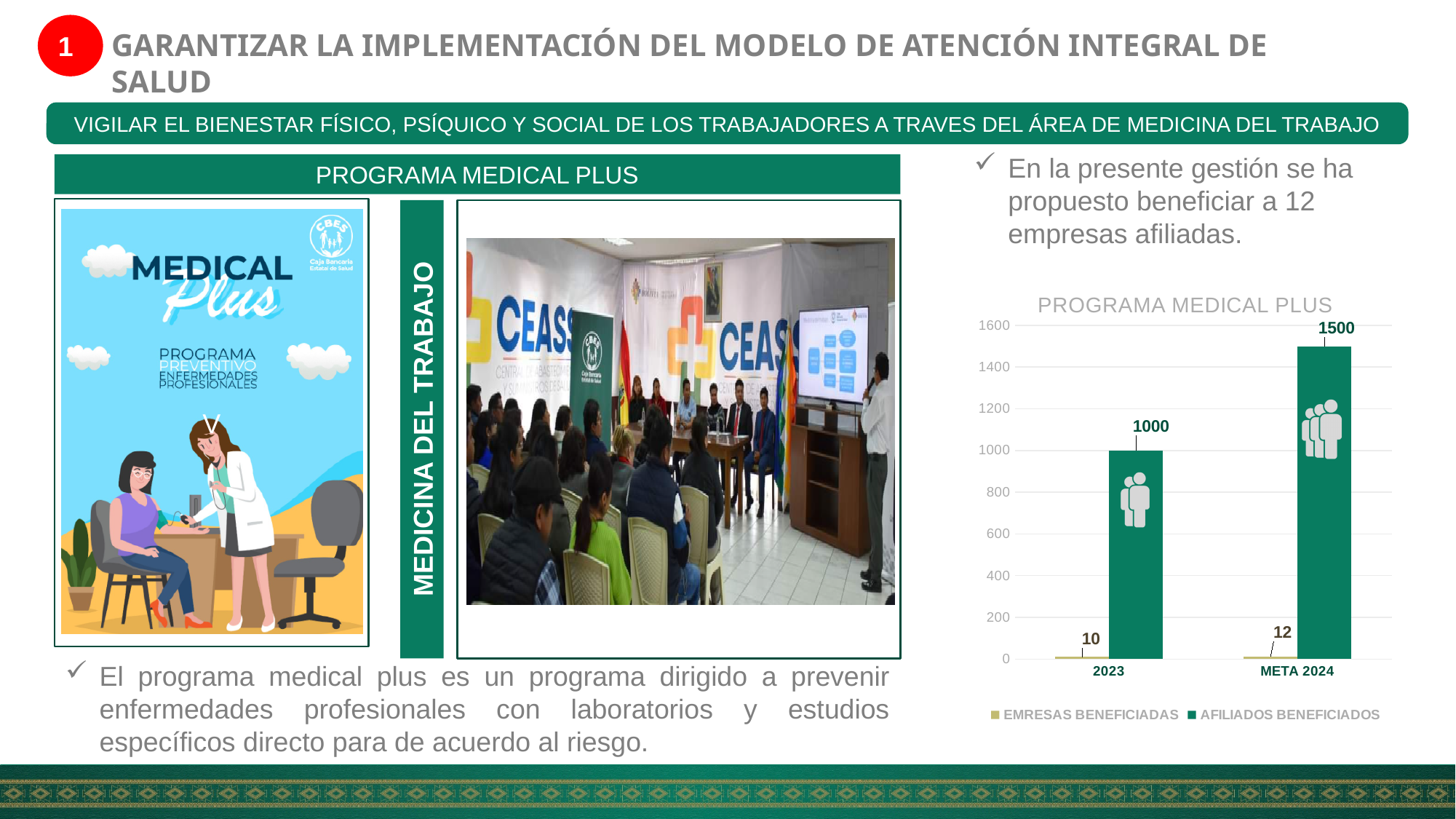
What is the value for AFILIADOS BENEFICIADOS in 2023? 1000 How many categories are shown on the x axis? 2 How many series does the legend list? 2 What is the value for EMRESAS BENEFICIADAS in 2023? 10 What is the value for EMRESAS BENEFICIADAS for META 2024? 12 Is the value for AFILIADOS BENEFICIADOS in 2023 greater or less than 1200? less What is the difference in EMRESAS BENEFICIADAS between META 2024 and 2023? 2 Which category has the higher value for AFILIADOS BENEFICIADOS? META 2024 What is the difference in AFILIADOS BENEFICIADOS between META 2024 and 2023? 500 What is the value for AFILIADOS BENEFICIADOS for META 2024? 1500 What is the title of the chart? PROGRAMA MEDICAL PLUS What kind of chart is shown? bar chart